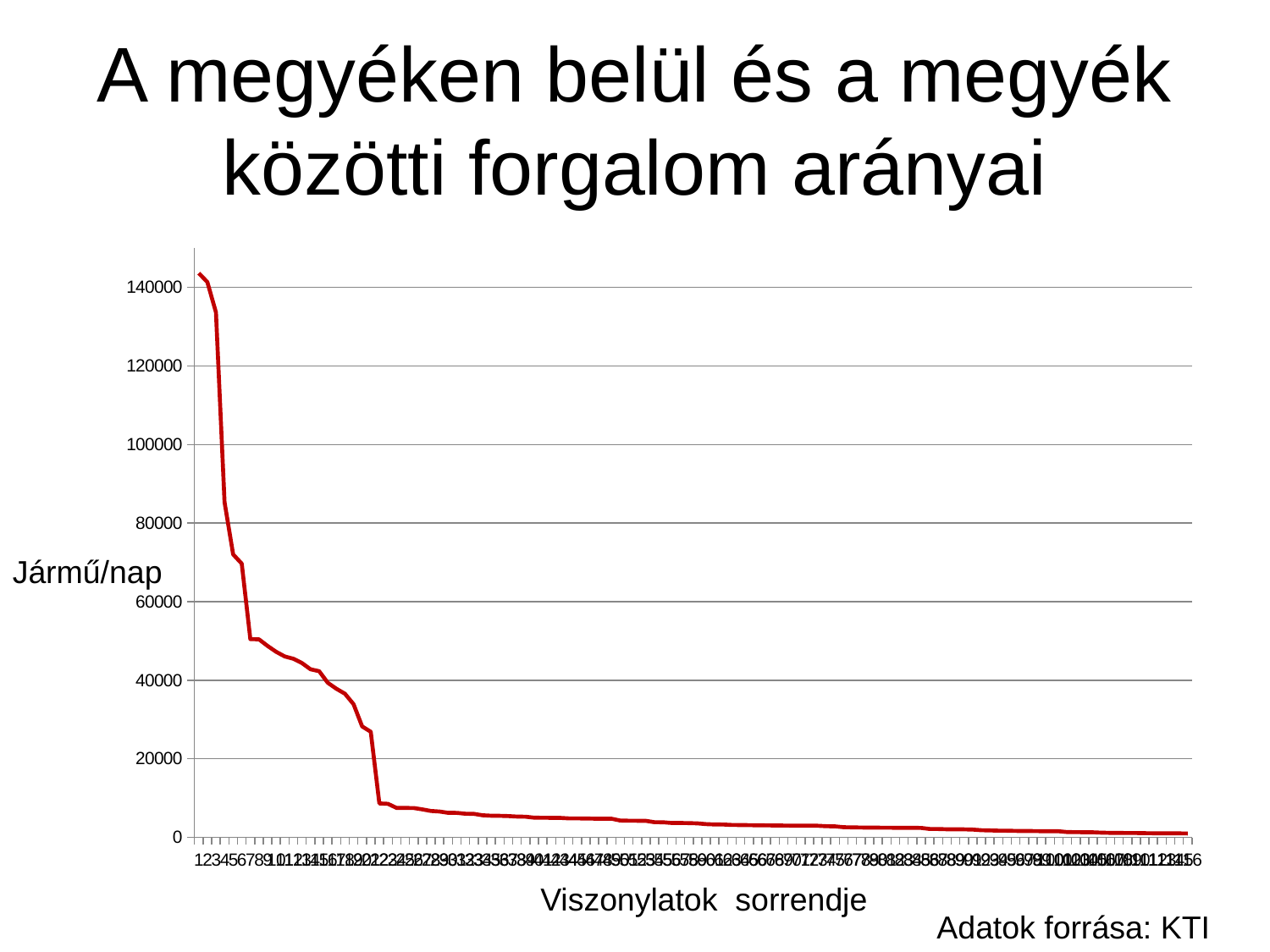
Do the values rise or fall as you move from left to right along the x axis? fall What is the label of the vertical axis? Jármű/nap How many data series are plotted on the chart? 1 What kind of chart is shown on the slide? line chart Is the value at position 10 on the x axis greater or less than 60000? less Which position on the x axis has the highest value? 1 What is the label of the horizontal axis? Viszonylatok sorrendje Is the value at position 10 on the x axis greater or less than 40000? greater Is the value at the first position (1) on the x axis greater or less than 120000? greater